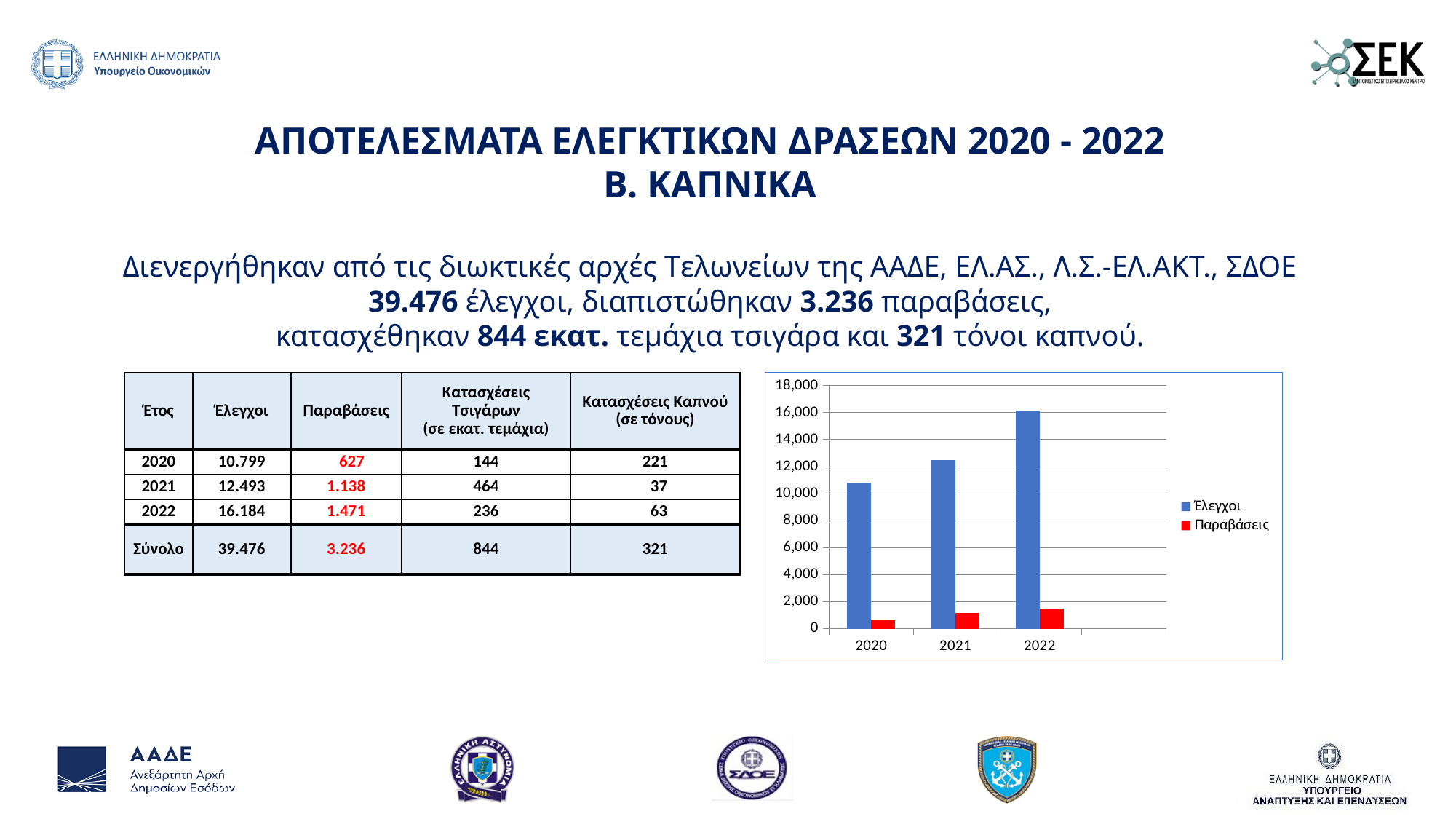
In which year is the Έλεγχοι bar the lowest? 2020 For 2021, which is larger: Έλεγχοι or Παραβάσεις? Έλεγχοι Do the Έλεγχοι values rise or fall from 2020 to 2022? rise According to the slide, what is the Έλεγχοι value plotted for 2021? 12.493 Is the Έλεγχοι value for 2022 greater or less than 14,000? greater Which colour represents Παραβάσεις in the chart's legend? red Is the Έλεγχοι value for 2020 greater or less than 12,000? less How many series does the chart's legend list? 2 What kind of chart is shown on the slide? bar chart Is the Παραβάσεις value for 2021 greater or less than 2,000? less In which year is the Έλεγχοι bar the highest? 2022 How many years are shown on the x axis of the chart? 3